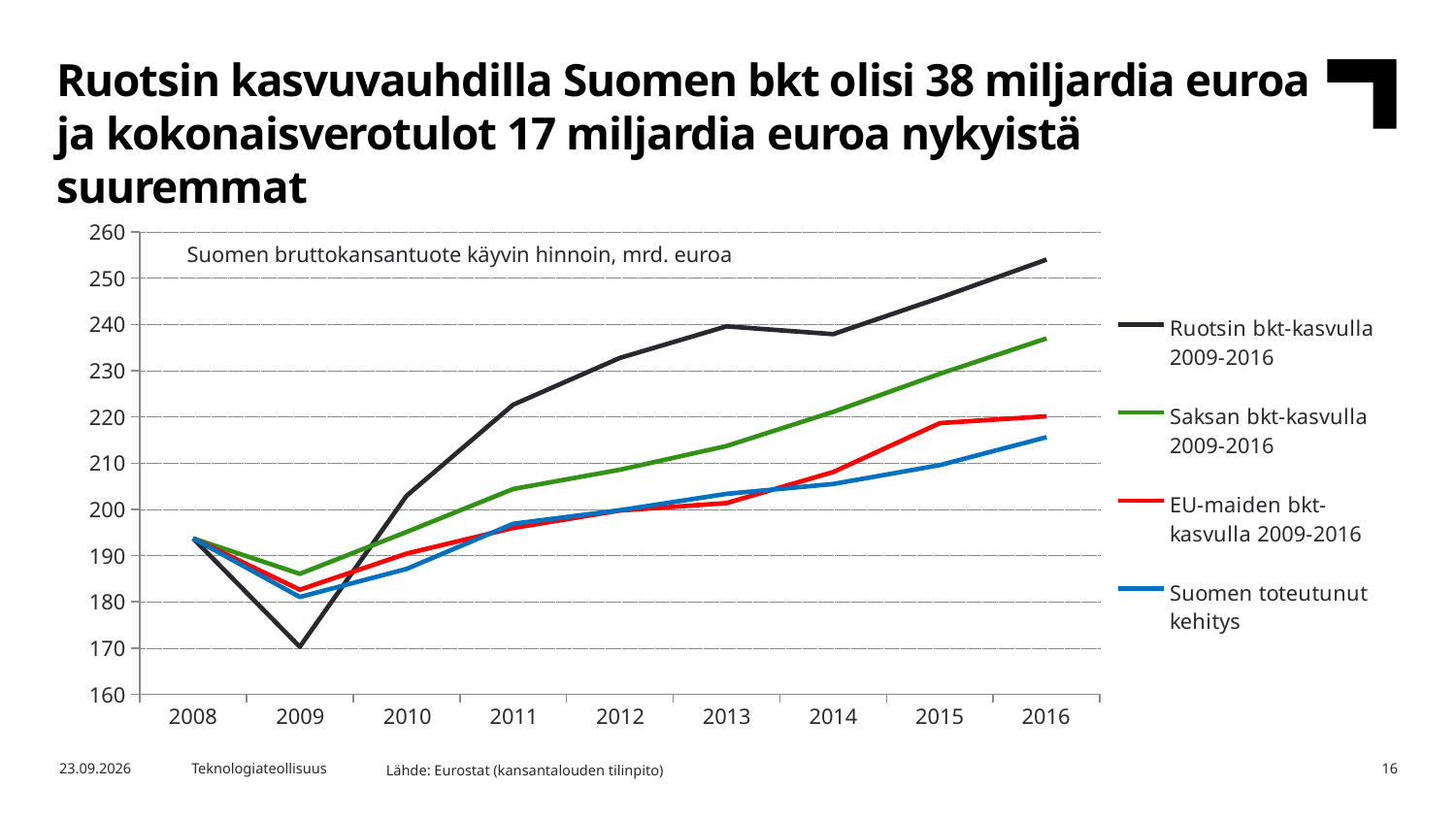
Which series has the highest value in 2016? Ruotsin bkt-kasvulla 2009-2016 How many years are plotted along the x axis? 9 Which series has the lowest value in 2009? Ruotsin bkt-kasvulla 2009-2016 Is the value for Saksan bkt-kasvulla 2009-2016 in 2009 greater or less than 190? less What kind of chart is shown on the slide? line chart What is the title shown inside the chart area? Suomen bruttokansantuote käyvin hinnoin, mrd. euroa How many series does the legend list? 4 Is the value for Ruotsin bkt-kasvulla 2009-2016 in 2016 greater or less than 250? greater Does the Ruotsin bkt-kasvulla 2009-2016 line rise or fall from 2009 to 2016? rise Which series has the lowest value in 2016? Suomen toteutunut kehitys In 2015, which is larger: EU-maiden bkt-kasvulla 2009-2016 or Suomen toteutunut kehitys? EU-maiden bkt-kasvulla 2009-2016 Which series is drawn with a blue line? Suomen toteutunut kehitys